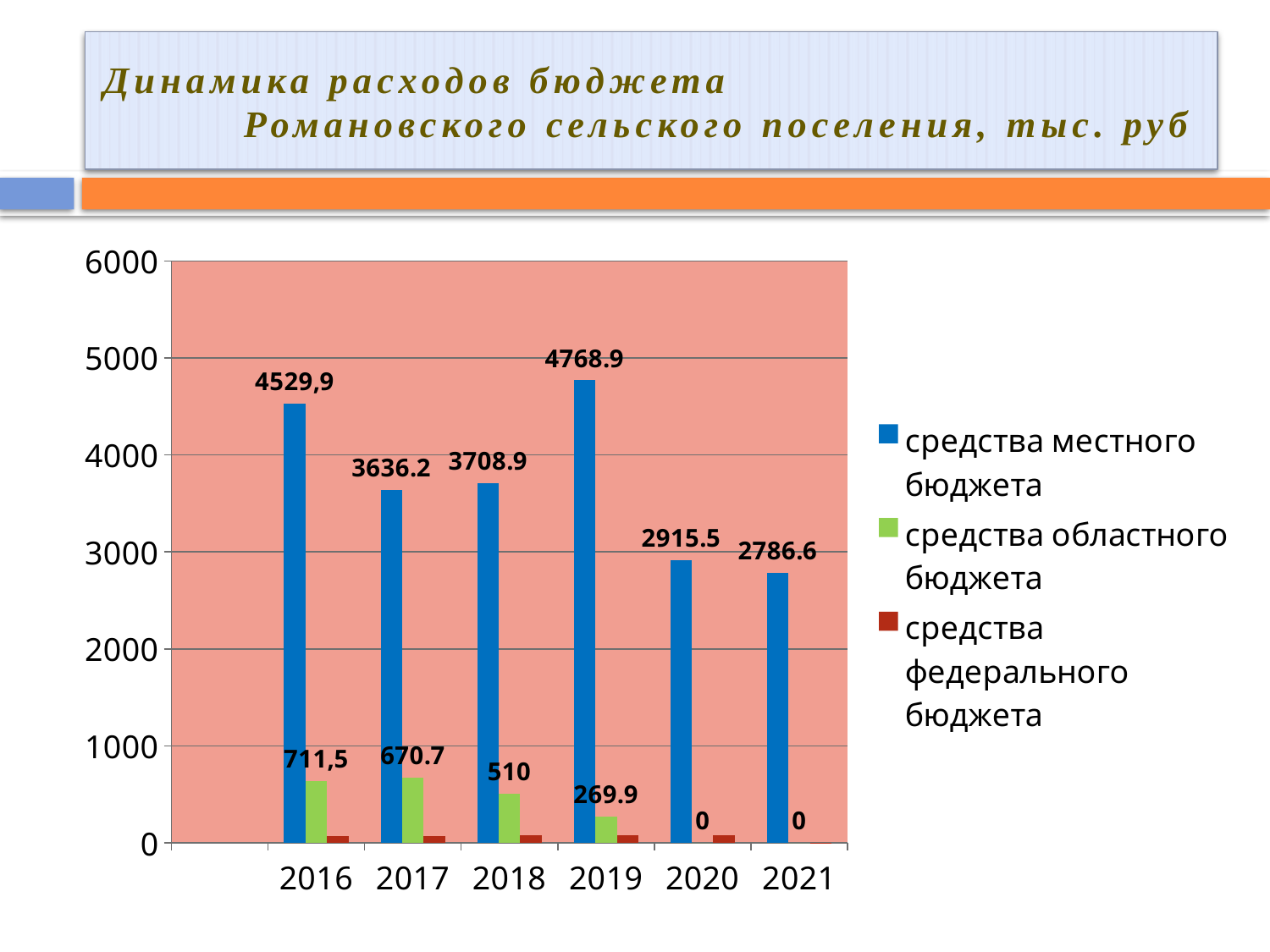
In which year is the value for средства местного бюджета the lowest? 2021 How many years are shown on the x axis? 6 What is the value for средства местного бюджета in 2016? 4529,9 In which year is the value for средства местного бюджета the highest? 2019 Is the value for средства местного бюджета in 2018 greater or less than 4000? less What kind of chart is shown on the slide? bar chart What is the difference between the средства местного бюджета values for 2020 and 2021? 128.9 What is the value for средства местного бюджета in 2019? 4768.9 What is the value for средства областного бюджета in 2020? 0 How many series does the legend list? 3 What is the value for средства областного бюджета in 2018? 510 Which is larger, the средства областного бюджета value for 2017 or for 2019? 2017